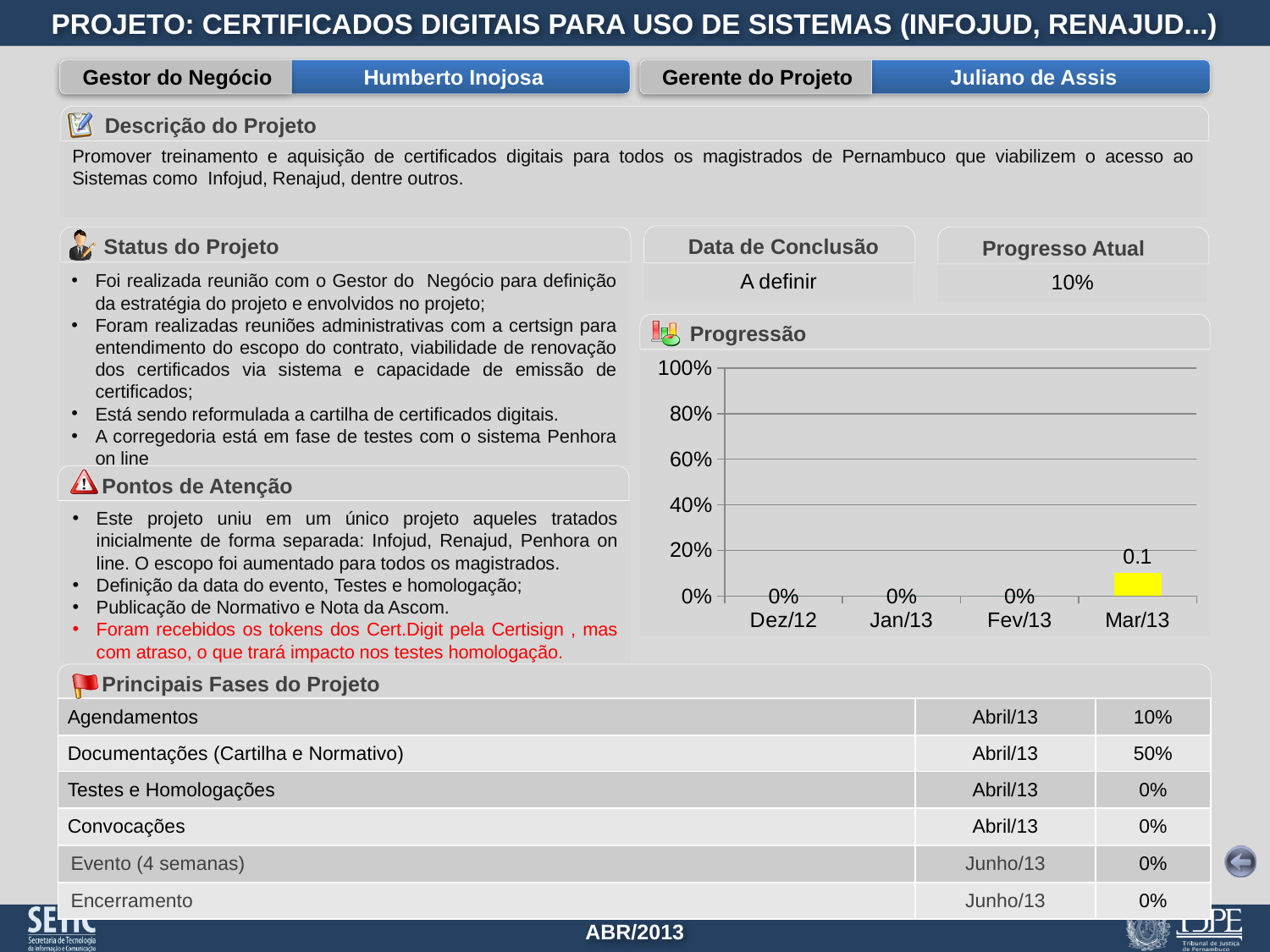
Is the value for Mar/13 in the Progressão chart greater or less than 20%? less How many months are shown on the x axis of the Progressão chart? 4 What is the data label shown for Mar/13 in the Progressão chart? 0.1 Which is larger in the Progressão chart, the value for Fev/13 or the value for Mar/13? Mar/13 What is the data label shown for Fev/13 in the Progressão chart? 0% What is the data label shown for Dez/12 in the Progressão chart? 0% Which month has the highest value in the Progressão chart? Mar/13 Do the values in the Progressão chart rise or fall from Dez/12 to Mar/13? rise What is the highest value shown on the y axis of the Progressão chart? 100% What is the data label shown for Jan/13 in the Progressão chart? 0% What colour is the bar for Mar/13 in the Progressão chart? yellow What kind of chart is the Progressão chart? bar chart